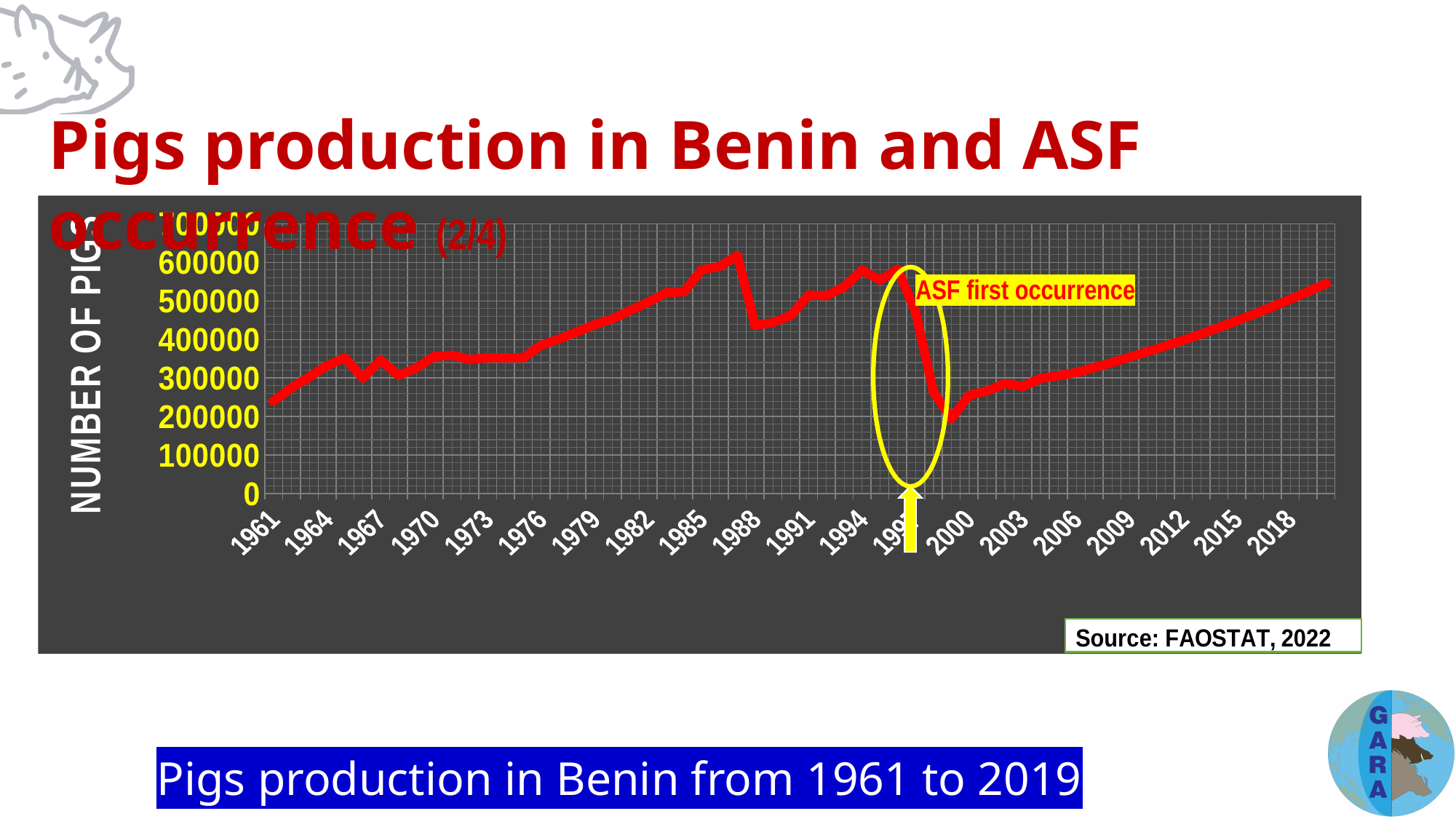
What event does the yellow annotation on the chart mark? ASF first occurrence Do the values rise or fall immediately after the ASF first occurrence in 1997? fall Do the values rise or fall between 2000 and 2018? rise How many year labels are shown on the x axis? 20 What kind of chart is shown on the slide? line chart Is the value for 1961 greater or less than 300000? less Is the peak value reached around 1987 greater or less than 600000? greater Which is larger, the peak value around 1987 or the value for 2018? around 1987 Which is larger, the value for 1961 or the value for 2018? 2018 What is the label of the vertical axis? NUMBER OF PIGS Is the lowest value reached just before 2000 greater or less than 300000? less